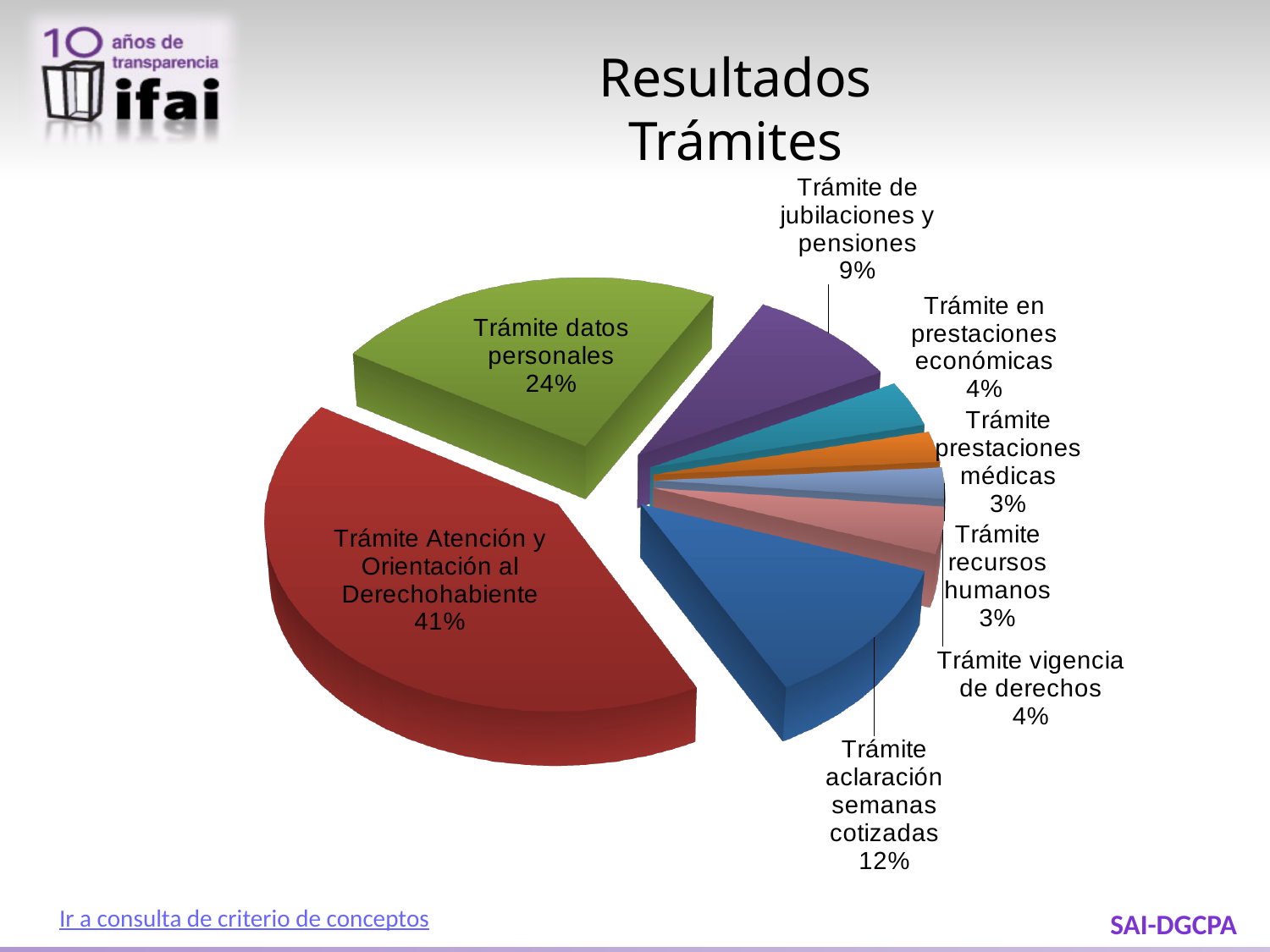
What percentage is shown for "Trámite prestaciones médicas"? 3% What is the title shown above the chart on the slide? Resultados Trámites What percentage is shown for "Trámite vigencia de derechos"? 4% Which is larger, the share for "Trámite aclaración semanas cotizadas" or the share for "Trámite de jubilaciones y pensiones"? Trámite aclaración semanas cotizadas What is the difference in percentage points between "Trámite Atención y Orientación al Derechohabiente" and "Trámite datos personales"? 17 What percentage is shown for "Trámite aclaración semanas cotizadas"? 12% How many categories (slices) does the pie chart have? 8 What percentage is shown for "Trámite de jubilaciones y pensiones"? 9% What percentage is shown for "Trámite datos personales"? 24% Which category has the largest share of the pie? Trámite Atención y Orientación al Derechohabiente What kind of chart is shown on the slide? pie chart What share of the pie does "Trámite Atención y Orientación al Derechohabiente" have? 41%